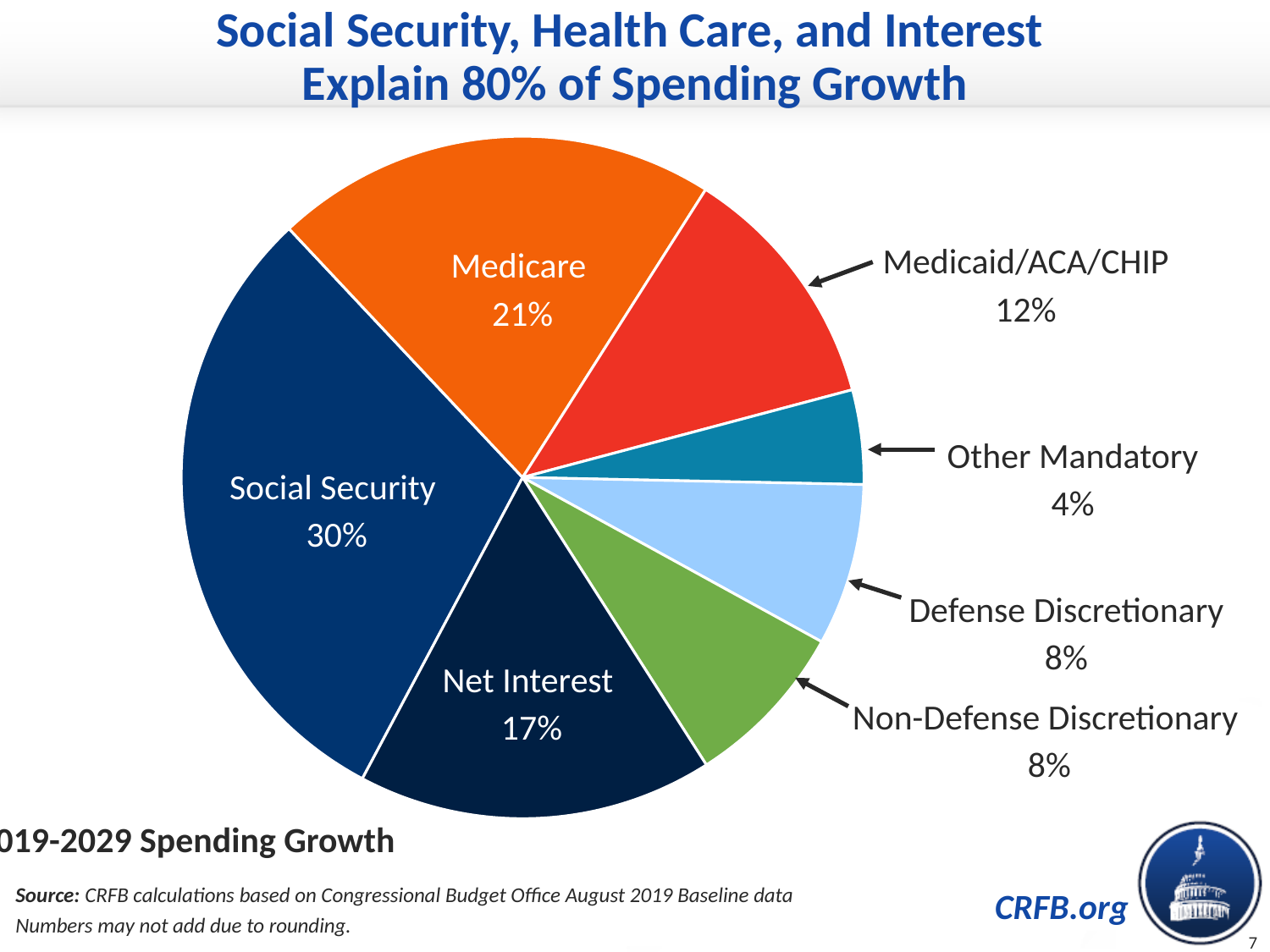
Which category accounts for the largest share of spending growth? Social Security What share of spending growth does Medicaid/ACA/CHIP account for? 12% What share of spending growth does Net Interest account for? 17% How many categories are shown in the pie chart? 7 Which is larger, the share for Net Interest or the share for Medicaid/ACA/CHIP? Net Interest What is the difference in percentage points between the Social Security share and the Medicare share? 9 What share of spending growth does Other Mandatory account for? 4% Which category accounts for the smallest share of spending growth? Other Mandatory What colour is the Medicare slice? Orange What share of spending growth does Social Security account for? 30% What share of spending growth does Medicare account for? 21% What kind of chart is shown on the slide? Pie chart